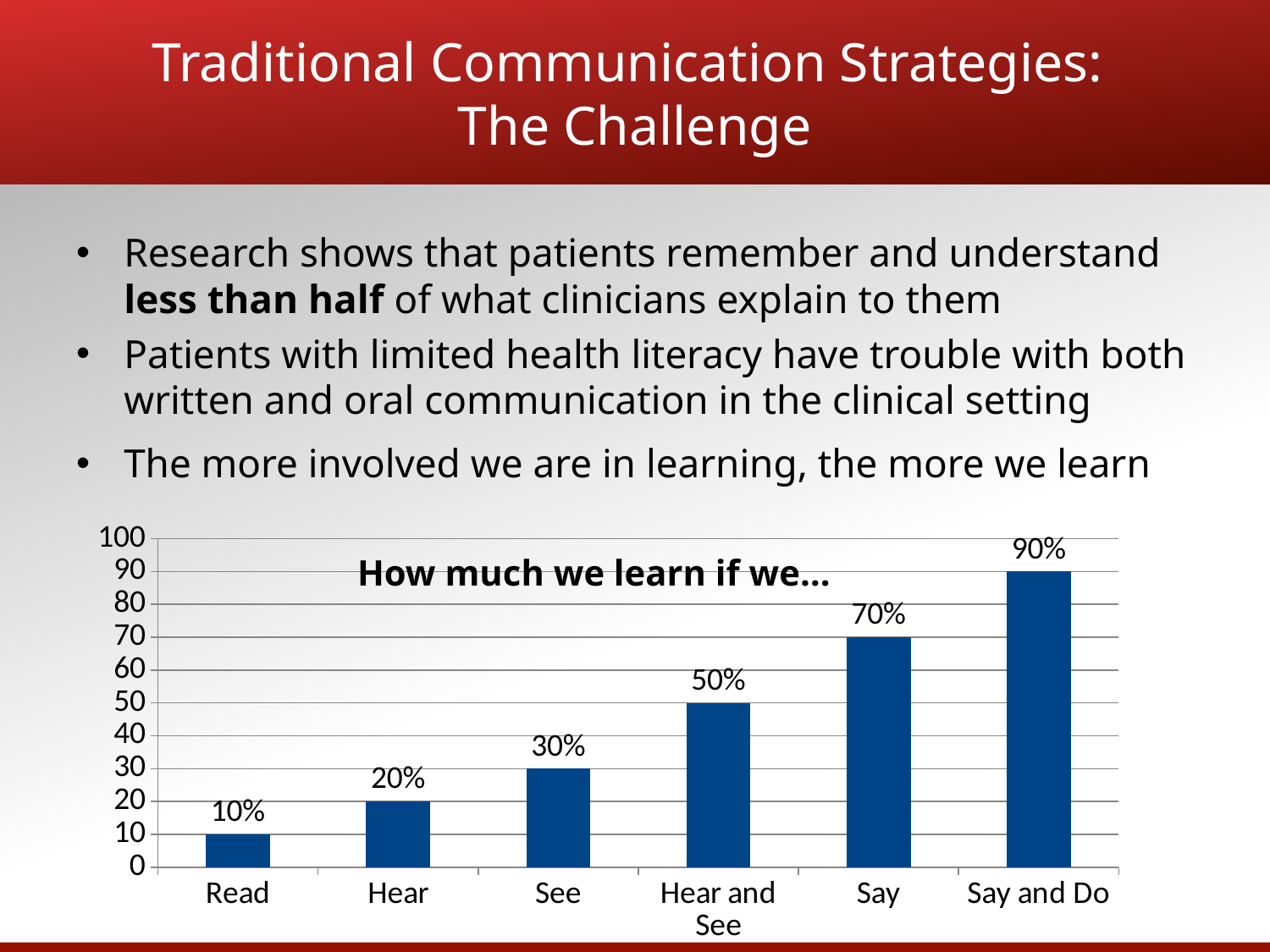
What is the value for Hear and See? 50% Do the values rise or fall from Read to Say and Do? Rise Which category has the highest value? Say and Do Which is larger, the value for Hear or the value for See? See What is the value for Say? 70% Is the value for Say greater or less than 60? greater How many categories are shown on the x axis? 6 What is the value for Read? 10% What kind of chart is this? Bar chart Which category has the lowest value? Read What is the difference between the values for Say and Do and See? 60% What is the title of the chart? How much we learn if we…